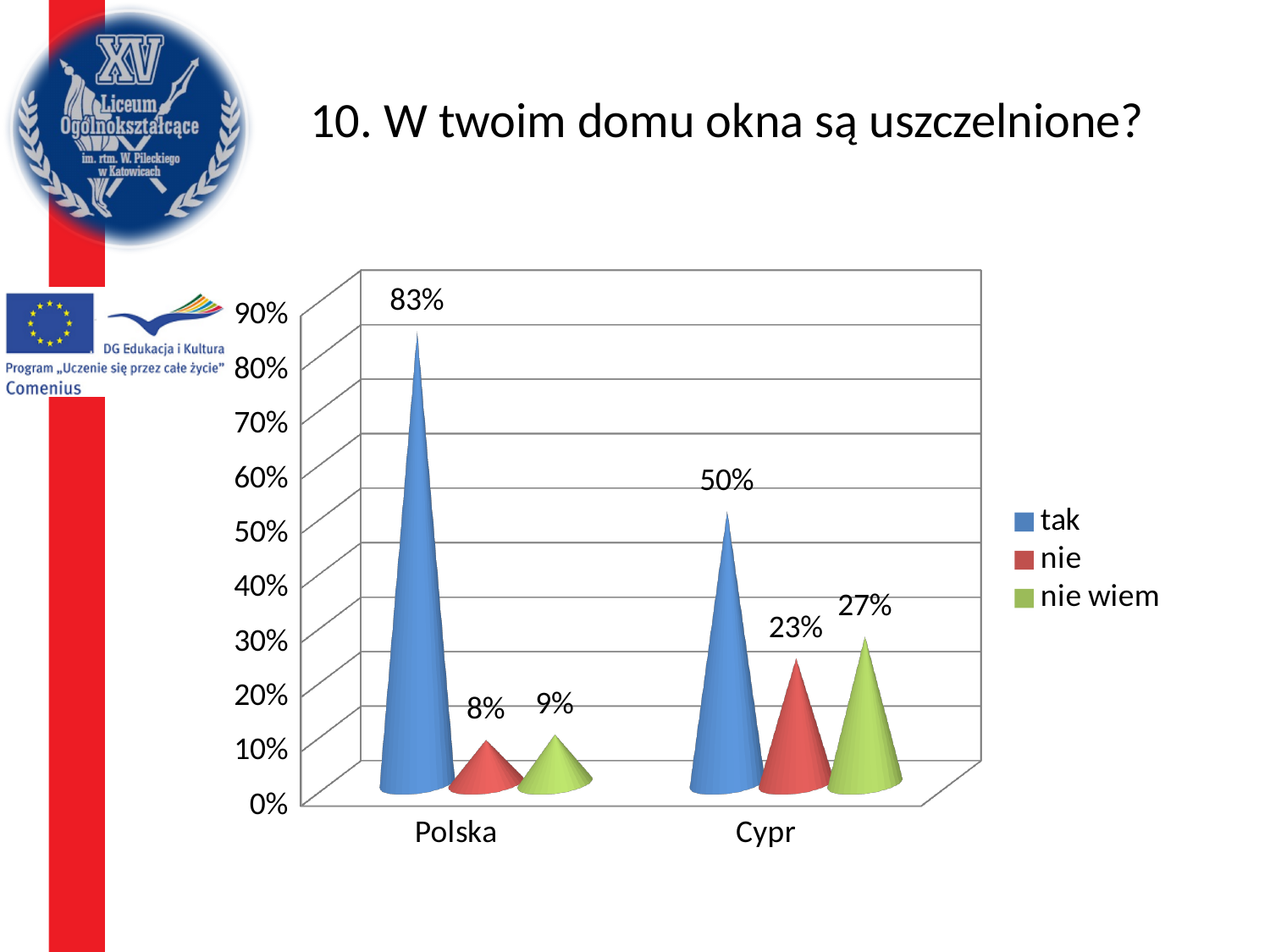
What colour represents the "nie wiem" series? green Which series has the highest value for Cypr? tak What is the difference between the "tak" values for Polska and Cypr? 33% What kind of chart is shown on the slide? bar chart Which is larger: "nie wiem" for Cypr or "nie" for Cypr? nie wiem for Cypr How many series does the legend list? 3 What is the value for "tak" in Polska? 83% How many categories are shown on the x axis? 2 What is the value for "nie" in Cypr? 23% What is the value for "tak" in Cypr? 50% What is the value for "nie wiem" in Polska? 9% Which series has the lowest value for Polska? nie